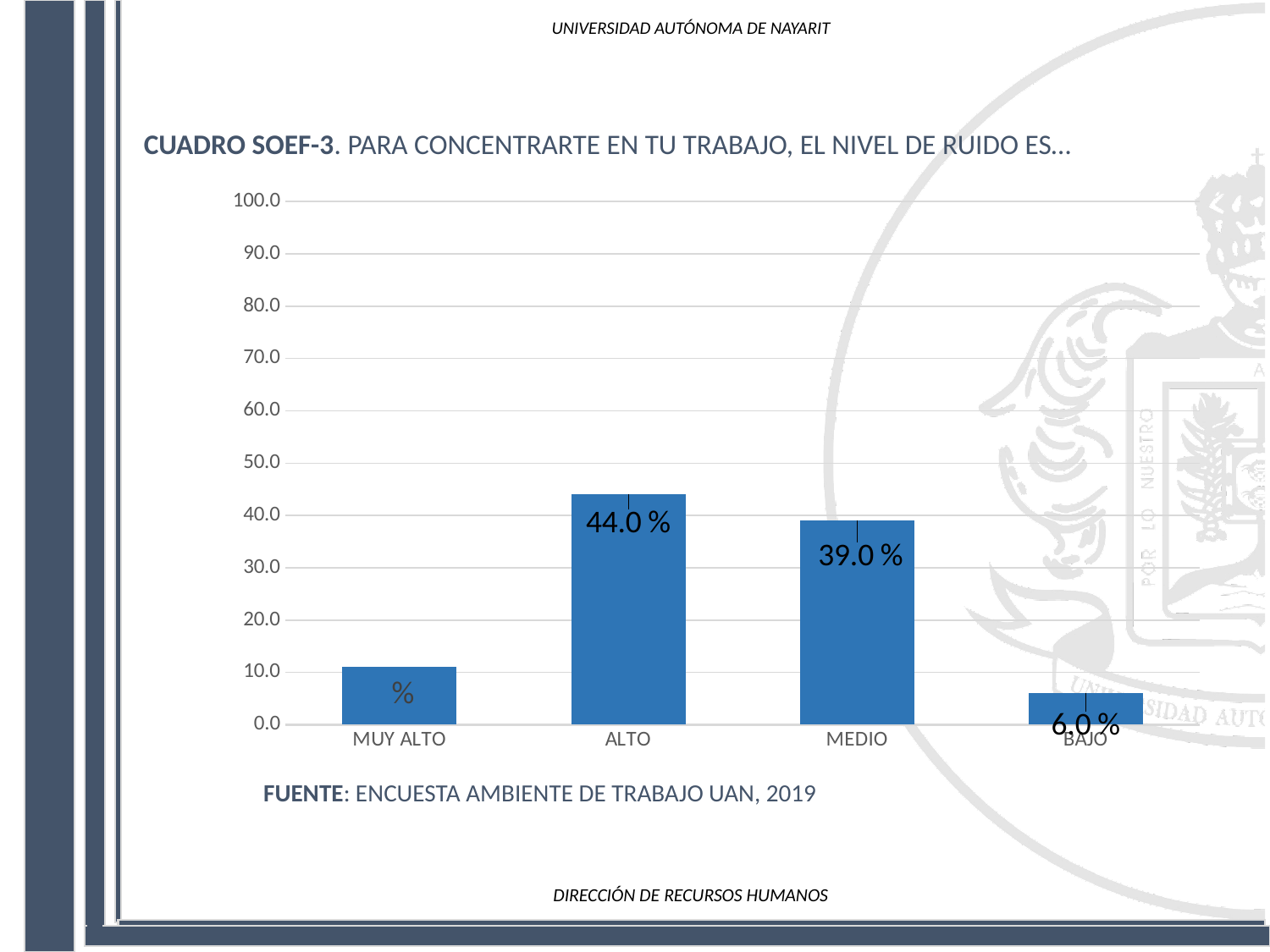
How many categories are shown on the x axis? 4 What is the difference between the values for ALTO and MEDIO? 5.0 % Is the value for MUY ALTO greater or less than 20? less Which category has the lowest value? BAJO What is the value for BAJO? 6.0 % What is the value for ALTO? 44.0 % What is the difference between the values for MEDIO and BAJO? 33.0 % What source is cited below the chart? ENCUESTA AMBIENTE DE TRABAJO UAN, 2019 Which is larger, the value for ALTO or the value for MEDIO? ALTO What is the value for MEDIO? 39.0 % What kind of chart is shown on the slide? bar chart Which category has the highest value? ALTO